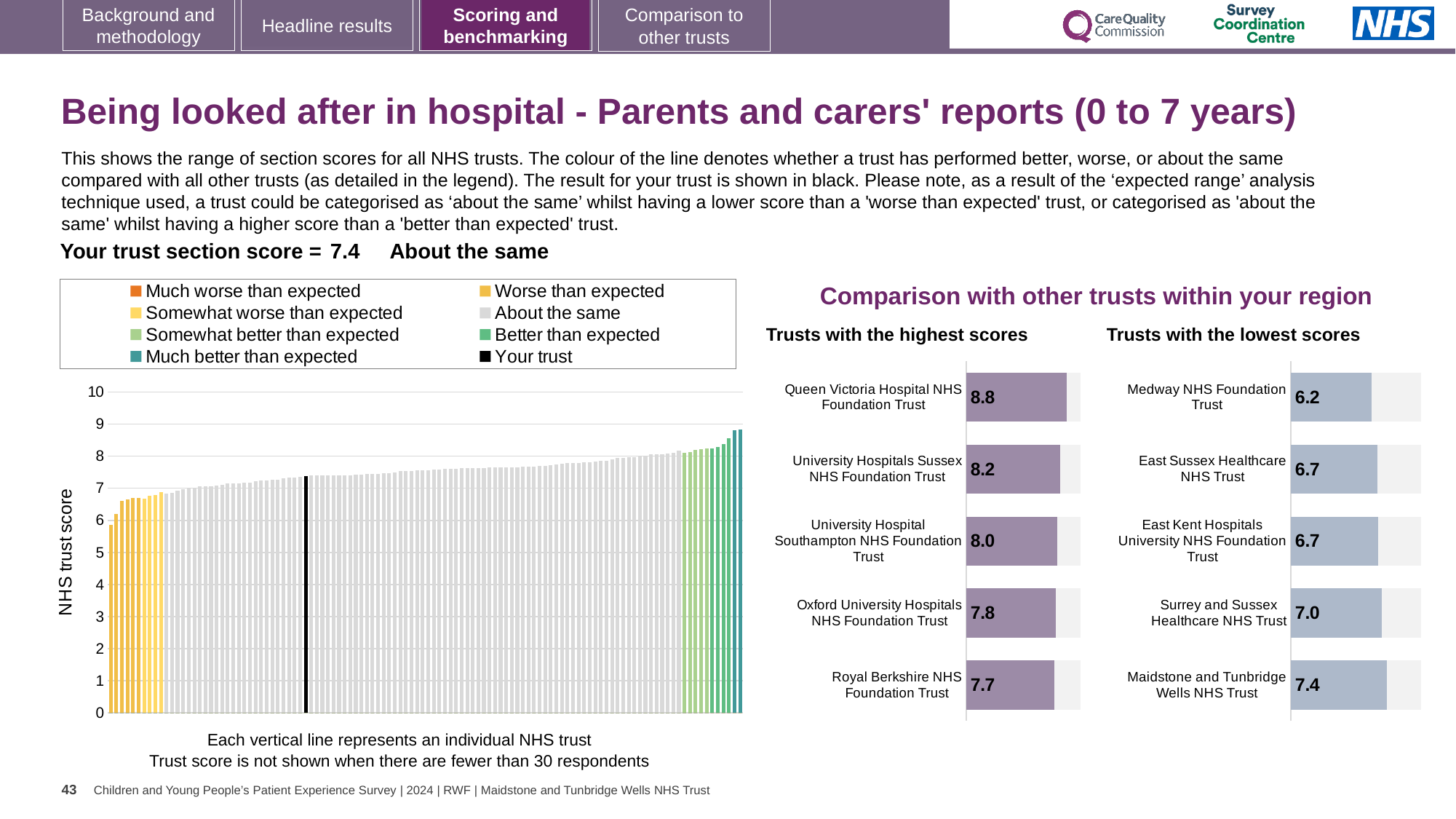
In the 'Trusts with the highest scores' chart, which trust has the lowest score? Royal Berkshire NHS Foundation Trust In the 'Trusts with the highest scores' chart, which has the higher score: University Hospitals Sussex NHS Foundation Trust or Oxford University Hospitals NHS Foundation Trust? University Hospitals Sussex NHS Foundation Trust In the main chart on the left, is the value for the tallest bar greater or less than 8? greater In the 'Trusts with the highest scores' chart, what is the difference between the scores of Queen Victoria Hospital NHS Foundation Trust and Royal Berkshire NHS Foundation Trust? 1.1 What kind of chart is the main chart on the left showing the range of section scores for all NHS trusts? bar chart In the 'Trusts with the lowest scores' chart, what is the score for Medway NHS Foundation Trust? 6.2 How many entries does the legend above the main chart on the left list? 8 How many trusts are shown in the 'Trusts with the lowest scores' chart? 5 In the main chart on the left, is the value for the black bar (Your trust) greater or less than 7? greater In the 'Trusts with the highest scores' chart, what is the score for Queen Victoria Hospital NHS Foundation Trust? 8.8 In the 'Trusts with the lowest scores' chart, which trust has the highest score? Maidstone and Tunbridge Wells NHS Trust In the main chart on the left, what is the label on the vertical axis? NHS trust score